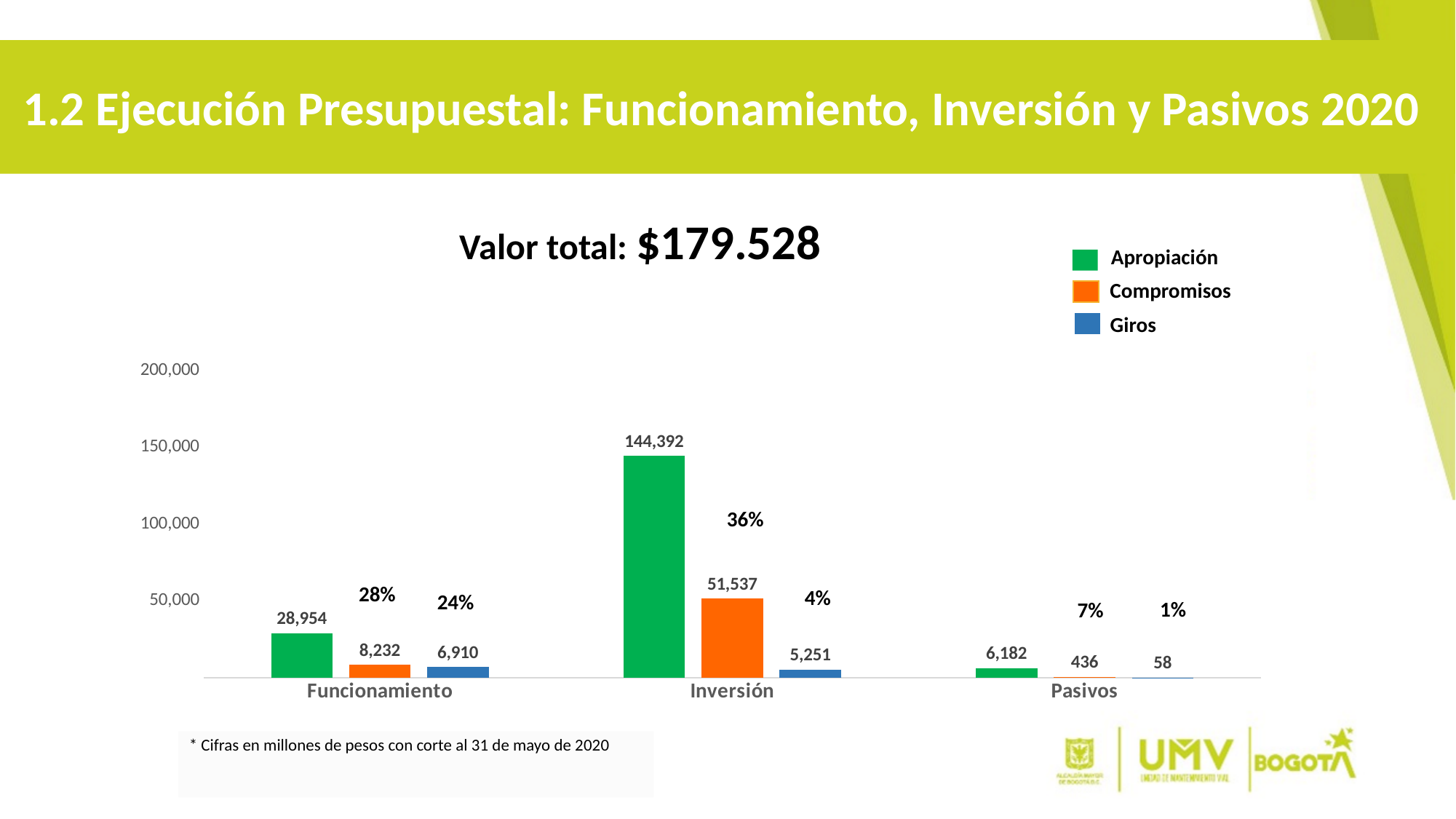
How many series does the legend list? 3 What is the difference between the Apropiación and Compromisos values for Inversión? 92,855 What is the Apropiación value for Inversión? 144,392 What is the Compromisos value for Funcionamiento? 8,232 Is the Apropiación value for Inversión greater or less than 100,000? greater What is the Giros value for Pasivos? 58 What colour represents the Compromisos series in the legend? Orange How many categories are shown on the x axis? 3 Which is larger, the Giros value for Funcionamiento or the Giros value for Inversión? Funcionamiento Which category has the lowest Compromisos value? Pasivos Which category has the highest Apropiación value? Inversión What kind of chart is shown on the slide? Bar chart